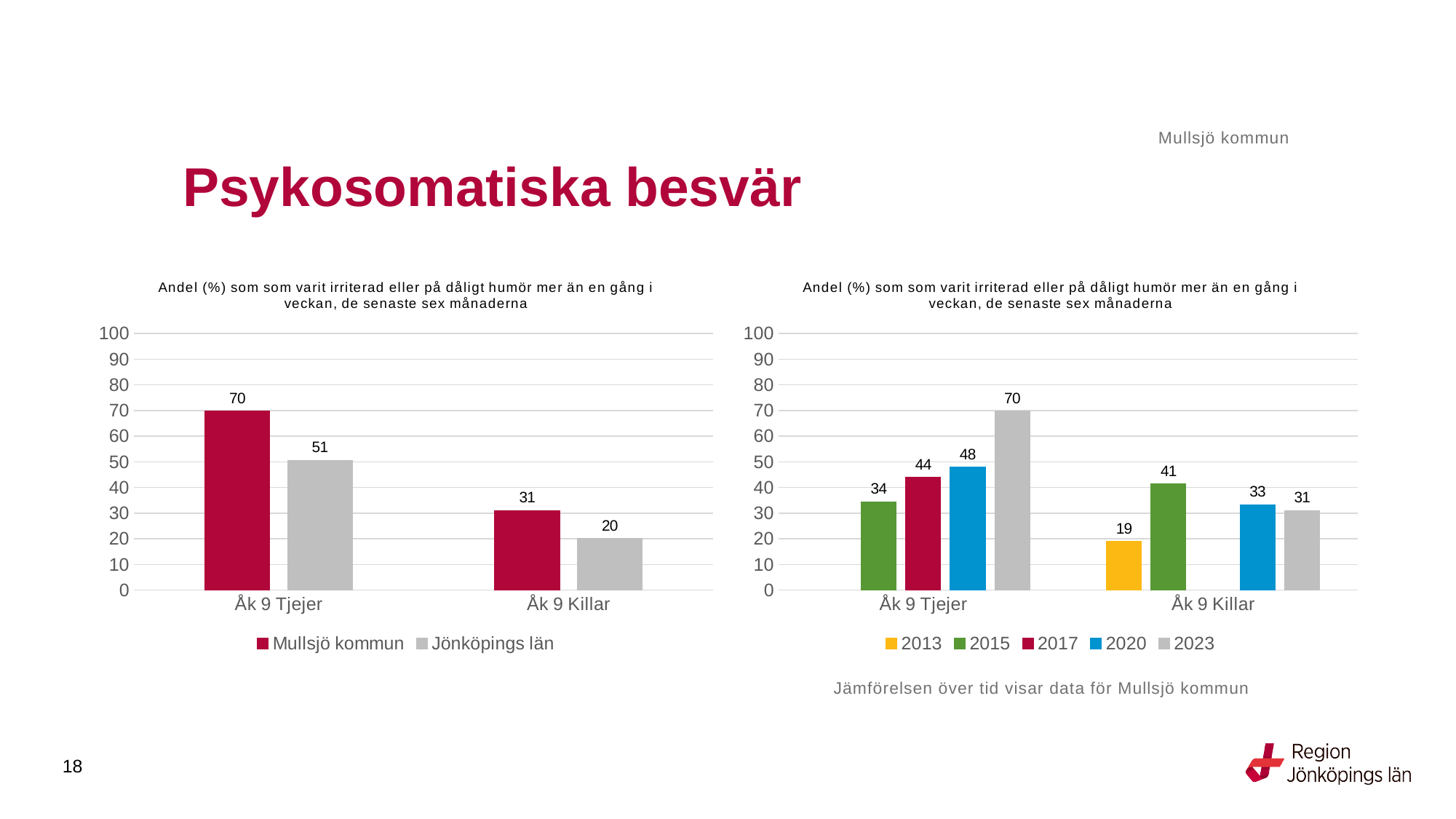
In the left chart, what is the difference between Mullsjö kommun and Jönköpings län for Åk 9 Tjejer? 19 In the right chart, what is the value for 2020 for Åk 9 Tjejer? 48 In the right chart, which year has the lowest value for Åk 9 Killar? 2013 In the right chart, which year has the highest value for Åk 9 Tjejer? 2023 In the right chart, what is the difference between 2023 and 2015 for Åk 9 Tjejer? 36 How many series does the legend of the left chart list? 2 In the right chart, what is the value for 2013 for Åk 9 Killar? 19 In the left chart, what is the value for Jönköpings län for Åk 9 Killar? 20 In the left chart, which is larger for Åk 9 Killar: Mullsjö kommun or Jönköpings län? Mullsjö kommun In the left chart, what is the value for Mullsjö kommun for Åk 9 Tjejer? 70 How many series does the legend of the right chart list? 5 What kind of chart is the left chart? Bar chart